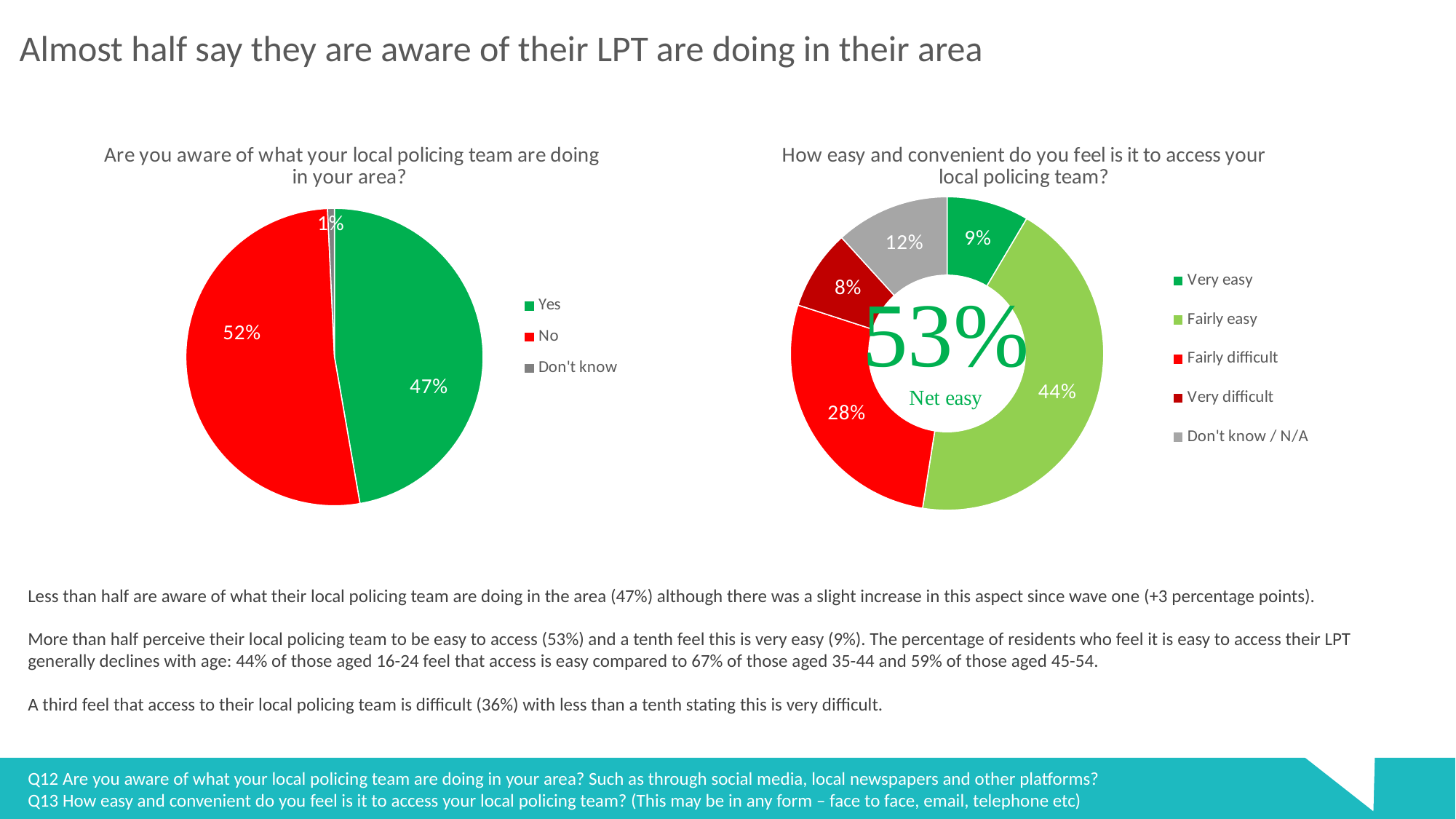
In the chart titled "How easy and convenient do you feel is it to access your local policing team?", which response has the largest share? Fairly easy In the chart titled "Are you aware of what your local policing team are doing in your area?", which response has the largest share? No In the chart titled "How easy and convenient do you feel is it to access your local policing team?", which is larger: Fairly difficult or Don't know / N/A? Fairly difficult In the chart titled "How easy and convenient do you feel is it to access your local policing team?", what figure is shown in the centre of the donut as Net easy? 53% What type of chart is the one titled "Are you aware of what your local policing team are doing in your area?" Pie chart In the chart titled "How easy and convenient do you feel is it to access your local policing team?", how many categories does the legend list? 5 In the chart titled "How easy and convenient do you feel is it to access your local policing team?", what percentage said Very difficult? 8% In the chart titled "Are you aware of what your local policing team are doing in your area?", what is the difference in percentage points between No and Yes? 5 percentage points In the chart titled "How easy and convenient do you feel is it to access your local policing team?", what percentage said Fairly easy? 44% In the chart titled "Are you aware of what your local policing team are doing in your area?", which response has the smallest share? Don't know In the chart titled "Are you aware of what your local policing team are doing in your area?", what percentage answered Yes? 47% In the chart titled "Are you aware of what your local policing team are doing in your area?", what percentage answered No? 52%